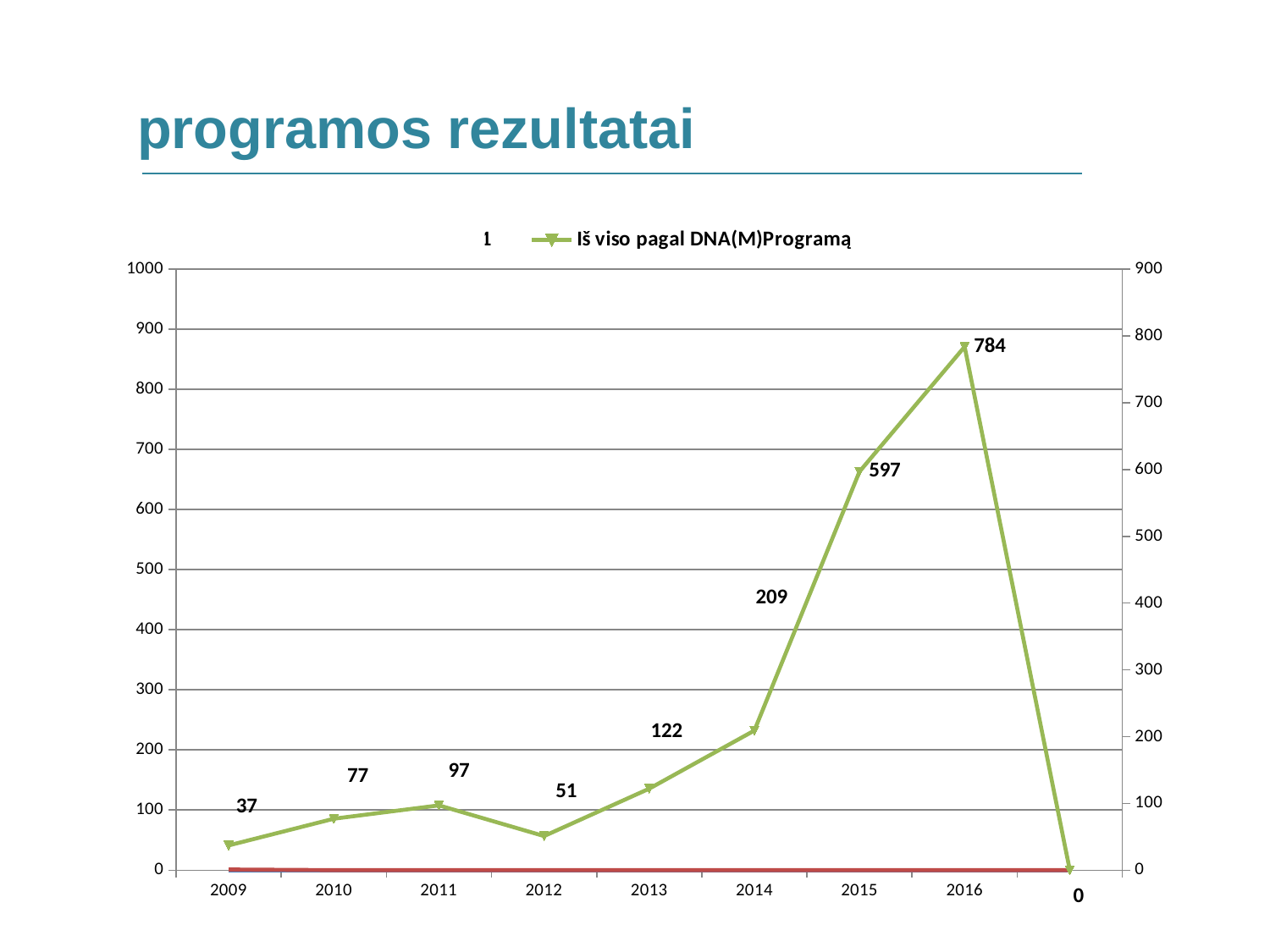
What kind of chart is shown on the slide? Line chart What is the value for 2013 in the Iš viso pagal DNA(M)Programą series? 122 Which year has the lowest value among the labelled years 2009 to 2016 in the Iš viso pagal DNA(M)Programą series? 2009 What is the value for 2016 in the Iš viso pagal DNA(M)Programą series? 784 Does the Iš viso pagal DNA(M)Programą series rise or fall from 2012 to 2016? Rise What is the value for 2015 in the Iš viso pagal DNA(M)Programą series? 597 What is the difference between the 2016 and 2015 values in the Iš viso pagal DNA(M)Programą series? 187 What is the value for 2009 in the Iš viso pagal DNA(M)Programą series? 37 What is the title of the slide? programos rezultatai How many series does the legend list? 2 Which is larger in the Iš viso pagal DNA(M)Programą series, the value for 2011 or the value for 2012? 2011 Which labelled year has the highest value in the Iš viso pagal DNA(M)Programą series? 2016